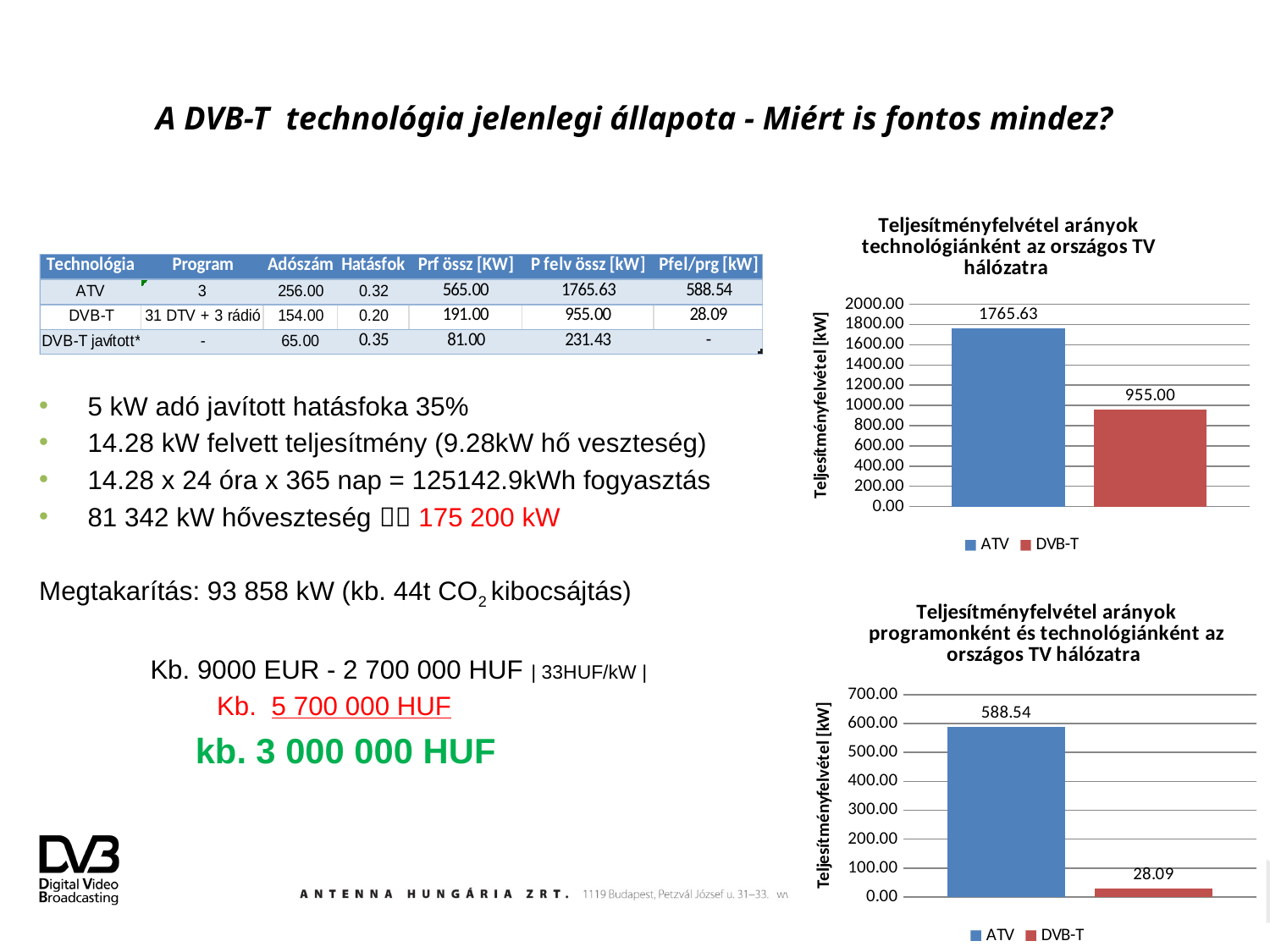
In the bottom chart (Teljesítményfelvétel arányok programonként és technológiánként az országos TV hálózatra), what is the value for DVB-T? 28.09 In the bottom chart (Teljesítményfelvétel arányok programonként és technológiánként az országos TV hálózatra), is the value for ATV greater or less than 500.00? greater In the top chart (Teljesítményfelvétel arányok technológiánként az országos TV hálózatra), what is the value for DVB-T? 955.00 What kind of chart is the bottom chart (Teljesítményfelvétel arányok programonként és technológiánként az országos TV hálózatra)? bar chart In the top chart (Teljesítményfelvétel arányok technológiánként az országos TV hálózatra), what is the difference between the ATV and DVB-T values? 810.63 In the bottom chart (Teljesítményfelvétel arányok programonként és technológiánként az országos TV hálózatra), what is the difference between the ATV and DVB-T values? 560.45 In the top chart (Teljesítményfelvétel arányok technológiánként az országos TV hálózatra), how many series does the legend list? 2 In the top chart (Teljesítményfelvétel arányok technológiánként az országos TV hálózatra), which series has the higher value? ATV In the bottom chart (Teljesítményfelvétel arányok programonként és technológiánként az országos TV hálózatra), which series has the lower value? DVB-T In the top chart (Teljesítményfelvétel arányok technológiánként az országos TV hálózatra), what is the y-axis label? Teljesítményfelvétel [kW] In the bottom chart (Teljesítményfelvétel arányok programonként és technológiánként az országos TV hálózatra), what is the value for ATV? 588.54 In the top chart (Teljesítményfelvétel arányok technológiánként az országos TV hálózatra), what is the value for ATV? 1765.63